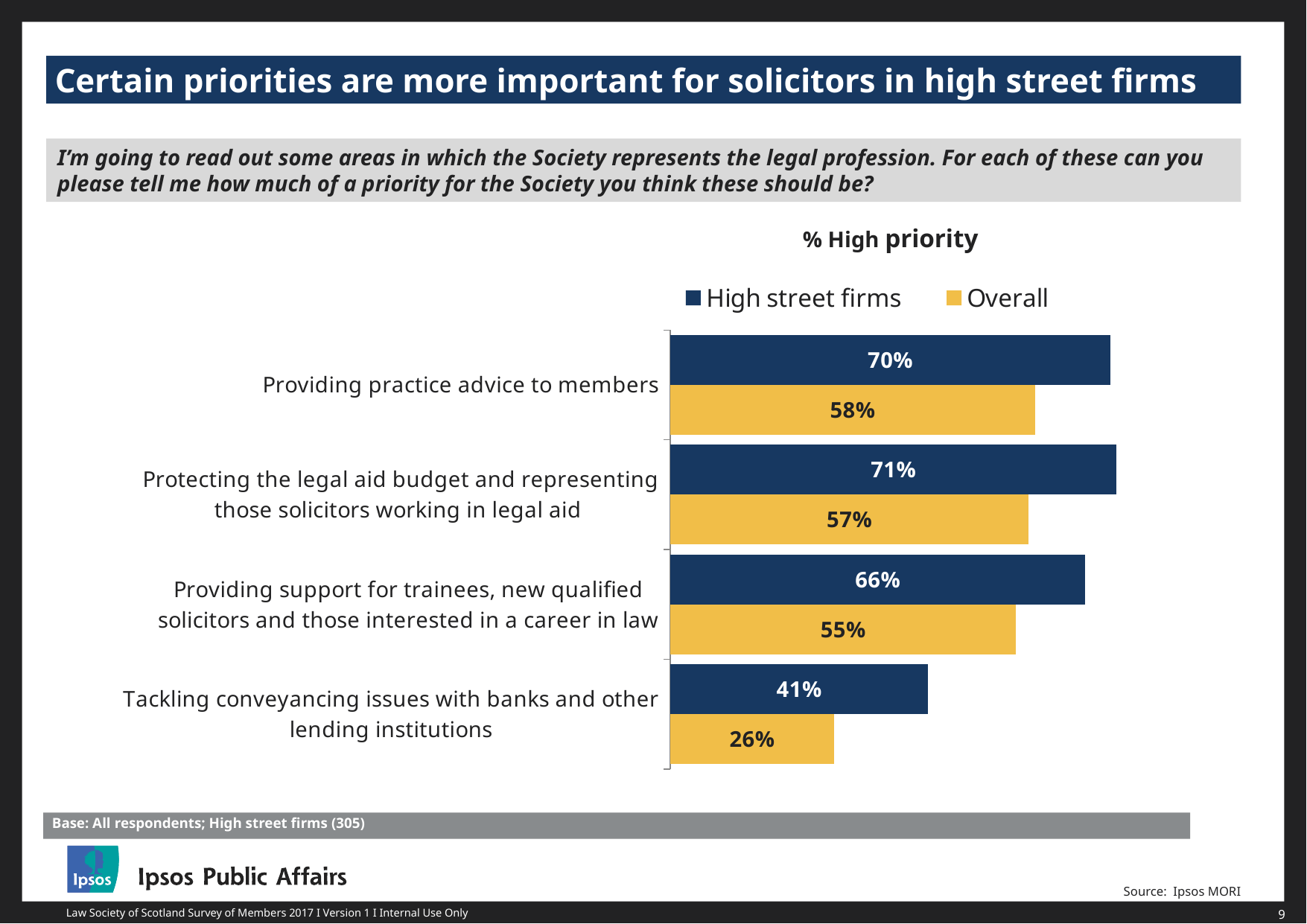
How many categories are shown in the chart? 4 What is the difference between the High street firms and Overall values for 'Providing practice advice to members'? 12 percentage points What is the difference between the High street firms and Overall values for 'Tackling conveyancing issues with banks and other lending institutions'? 15 percentage points What kind of chart is shown on the slide? Bar chart What percentage of high street firms rate 'Providing practice advice to members' as a high priority? 70% Which colour represents the Overall series in the chart? Yellow Which category has the highest High street firms value? Protecting the legal aid budget and representing those solicitors working in legal aid Which category has the lowest Overall value? Tackling conveyancing issues with banks and other lending institutions Which is larger for 'Protecting the legal aid budget and representing those solicitors working in legal aid': the High street firms value or the Overall value? High street firms What is the Overall value for 'Providing support for trainees, new qualified solicitors and those interested in a career in law'? 55% What is the Overall value for 'Tackling conveyancing issues with banks and other lending institutions'? 26% How many series does the legend list? 2